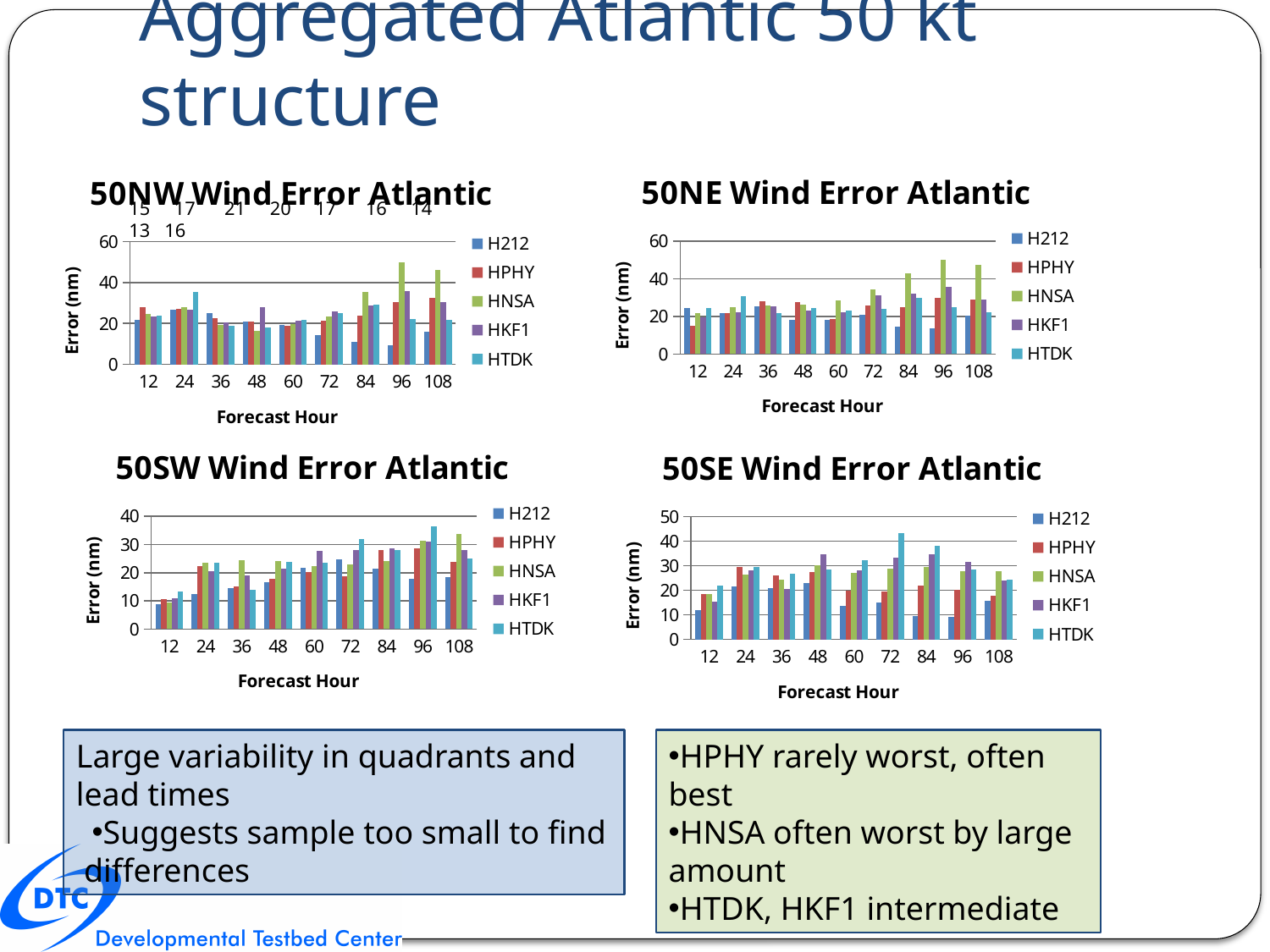
What is the y-axis title of the 50SW Wind Error Atlantic chart? Error (nm) In the 50SE Wind Error Atlantic chart, which is larger at forecast hour 48: the HKF1 value or the H212 value? HKF1 In the 50SE Wind Error Atlantic chart, which series has the tallest bar at forecast hour 72? HTDK What kind of chart is the 50NW Wind Error Atlantic chart? bar chart In the 50SE Wind Error Atlantic chart, is the HTDK value at forecast hour 72 greater or less than 40? greater In the 50NW Wind Error Atlantic chart, is the HNSA value at forecast hour 96 greater or less than 40? greater How many forecast hour categories are shown on the x axis of the 50SW Wind Error Atlantic chart? 9 In the 50NW Wind Error Atlantic chart, is the H212 value at forecast hour 96 greater or less than 20? less How many series does the legend of the 50NE Wind Error Atlantic chart list? 5 In the 50NE Wind Error Atlantic chart, which series has the tallest bar at forecast hour 96? HNSA